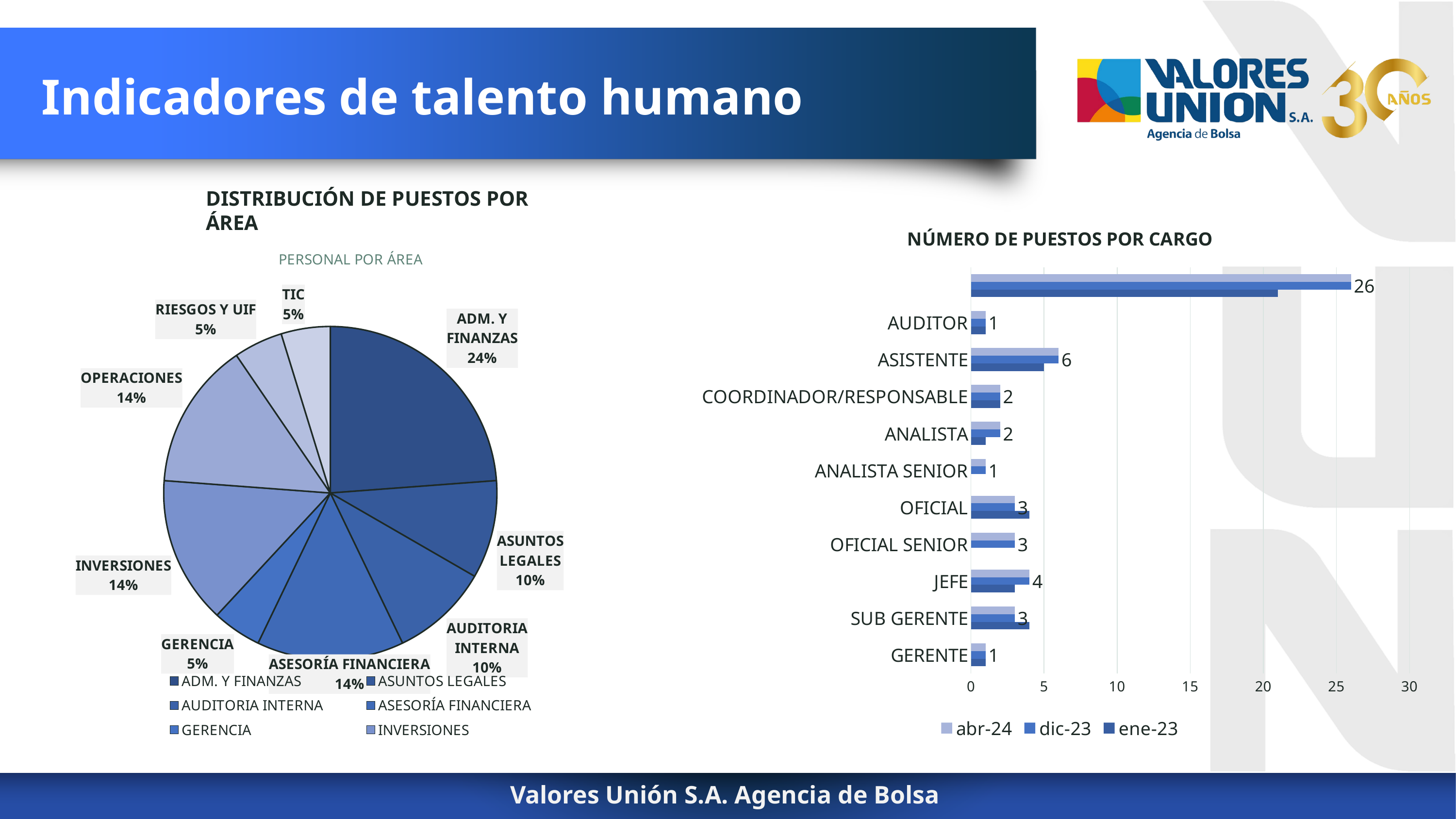
What kind of chart is 'NÚMERO DE PUESTOS POR CARGO'? Bar chart In the pie chart 'DISTRIBUCIÓN DE PUESTOS POR ÁREA', how many percentage points larger is ADM. Y FINANZAS than GERENCIA? 19 percentage points In the chart 'NÚMERO DE PUESTOS POR CARGO', what is the abr-24 value for ASISTENTE? 6 In the pie chart 'DISTRIBUCIÓN DE PUESTOS POR ÁREA', which area has the largest share? ADM. Y FINANZAS In the pie chart 'DISTRIBUCIÓN DE PUESTOS POR ÁREA', what share does ADM. Y FINANZAS have? 24% How many slices does the pie chart 'DISTRIBUCIÓN DE PUESTOS POR ÁREA' have? 9 In the pie chart 'DISTRIBUCIÓN DE PUESTOS POR ÁREA', what share does OPERACIONES have? 14% In the chart 'NÚMERO DE PUESTOS POR CARGO', what are the three series named in the legend? abr-24, dic-23, ene-23 In the chart 'NÚMERO DE PUESTOS POR CARGO', what is the abr-24 value for JEFE? 4 How many series does the legend of the chart 'NÚMERO DE PUESTOS POR CARGO' list? 3 What kind of chart is 'DISTRIBUCIÓN DE PUESTOS POR ÁREA'? Pie chart In the chart 'NÚMERO DE PUESTOS POR CARGO', which has the larger abr-24 value, ASISTENTE or AUDITOR? ASISTENTE